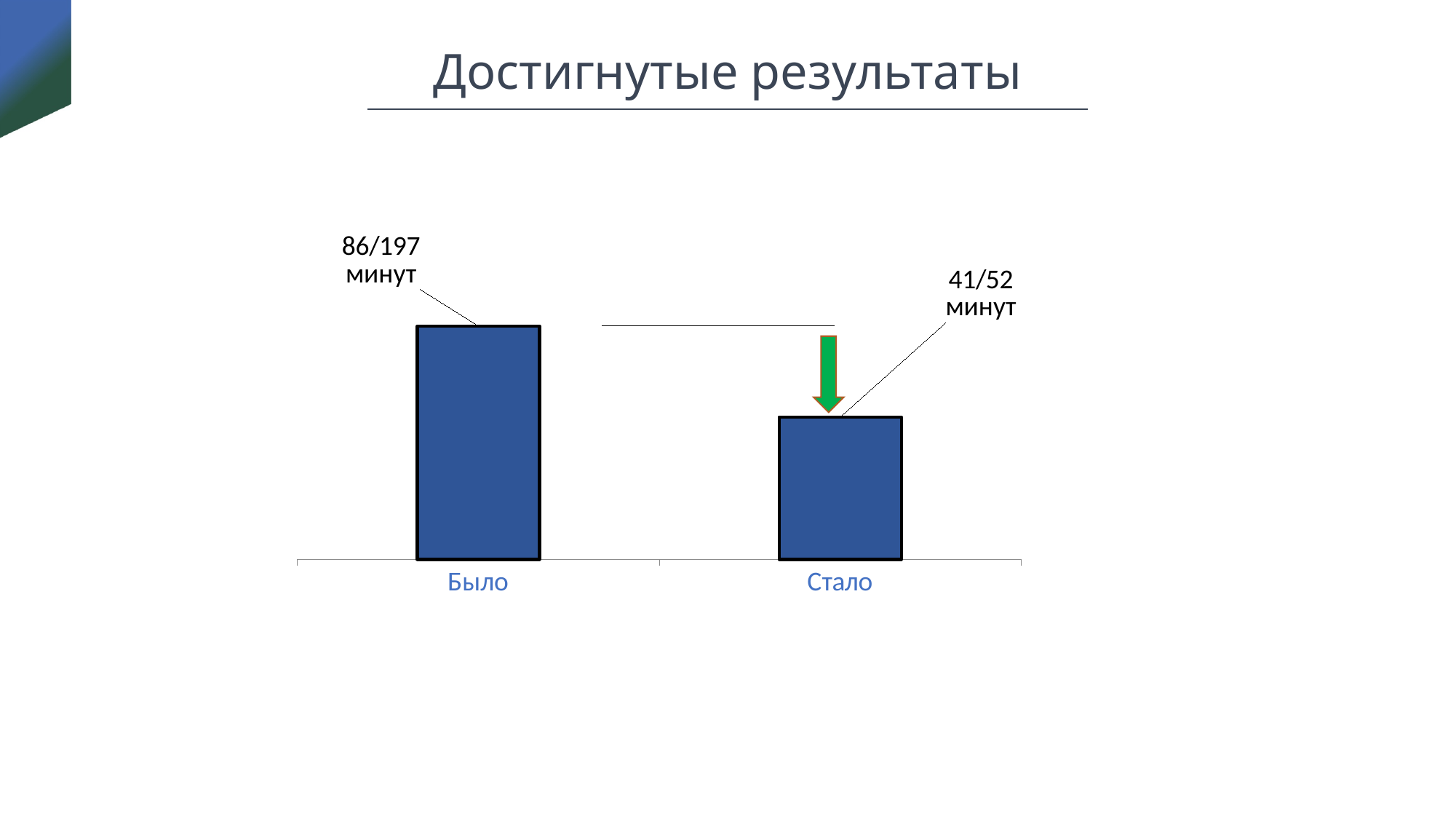
What colour is the arrow pointing down at the "Стало" bar? green What are the two category labels on the x axis? Было, Стало What is the data label shown for the "Стало" bar? 41/52 минут What is the data label shown for the "Было" bar? 86/197 минут Which category has the taller bar? Было How many bars are plotted in the chart? 2 What kind of chart is shown on the slide? bar chart Is the bar for "Было" taller or shorter than the bar for "Стало"? taller Do the bar values rise or fall from "Было" to "Стало"? fall Which category has the shorter bar? Стало What is the title of the slide containing the chart? Достигнутые результаты